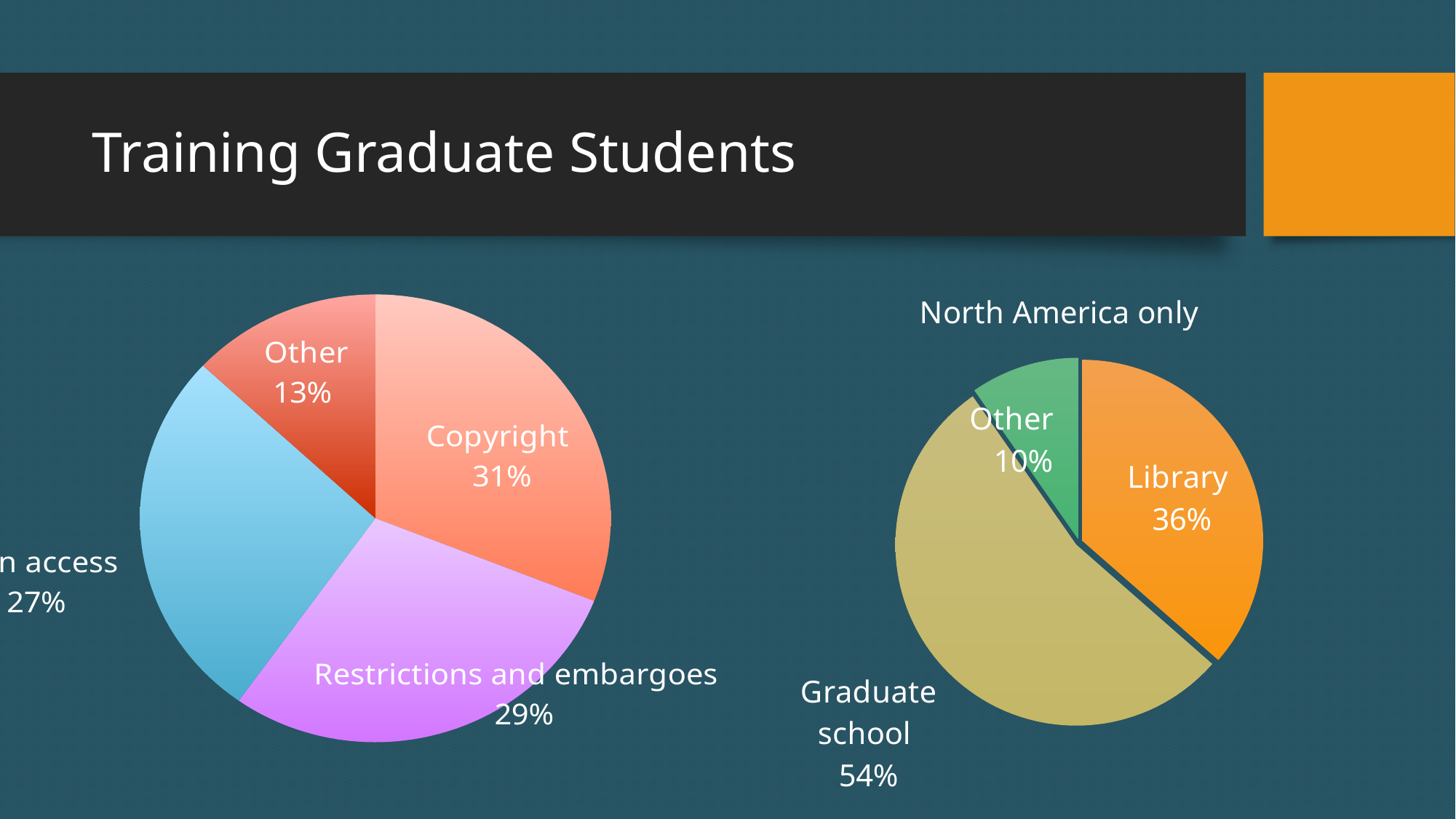
In the left pie chart, what percentage is shown for Copyright? 31% In the left pie chart, what is the difference in percentage points between Copyright and Restrictions and embargoes? 2 In the left pie chart, what percentage is shown for Other? 13% What type of chart is the 'North America only' chart? Pie chart In the 'North America only' chart, what percentage is shown for Library? 36% In the 'North America only' chart, what percentage is shown for Graduate school? 54% In the left pie chart, what percentage is shown for Restrictions and embargoes? 29% In the left pie chart, which slice has the smallest share? Other In the 'North America only' chart, which is larger, Library or Other? Library In the left pie chart, which labelled slice has the largest share? Copyright In the 'North America only' chart, what is the difference in percentage points between Graduate school and Library? 18 In the 'North America only' chart, which slice has the largest share? Graduate school